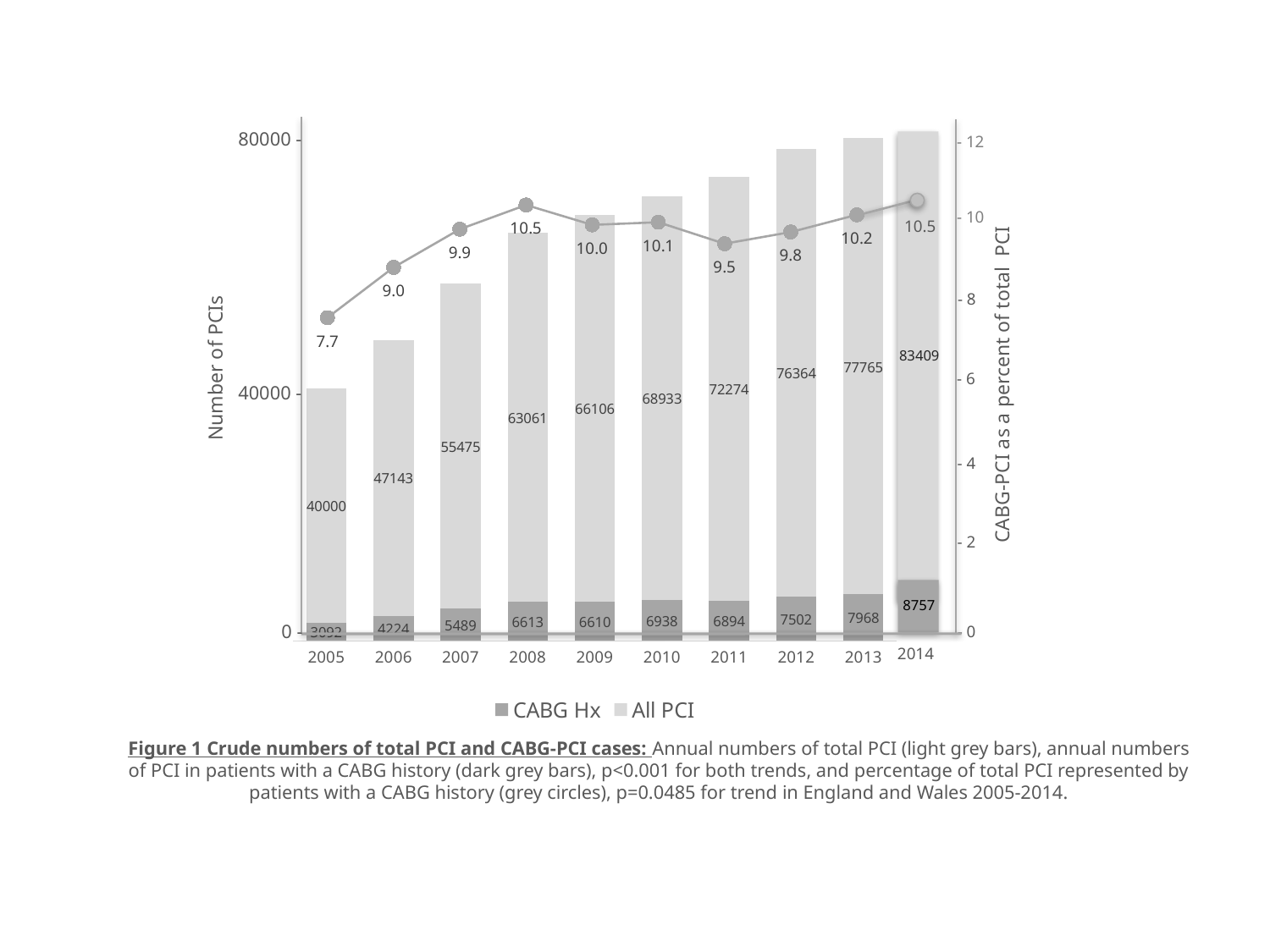
Which year has the lowest CABG-PCI percentage on the line? 2005 How many series does the legend list? 2 What is the difference between the All PCI values for 2014 and 2013? 5644 Is the All PCI value for 2006 greater or less than 40000? greater Which is larger, the CABG Hx value for 2011 or for 2012? 2012 What is the All PCI value for 2010? 68933 What percentage of total PCI is shown for 2011 on the line? 9.5 What is the title of the right-hand vertical axis? CABG-PCI as a percent of total PCI How many years are shown on the x axis? 10 Which year has the highest All PCI value? 2014 What is the difference between the CABG Hx values for 2014 and 2013? 789 What is the CABG Hx value for 2012? 7502